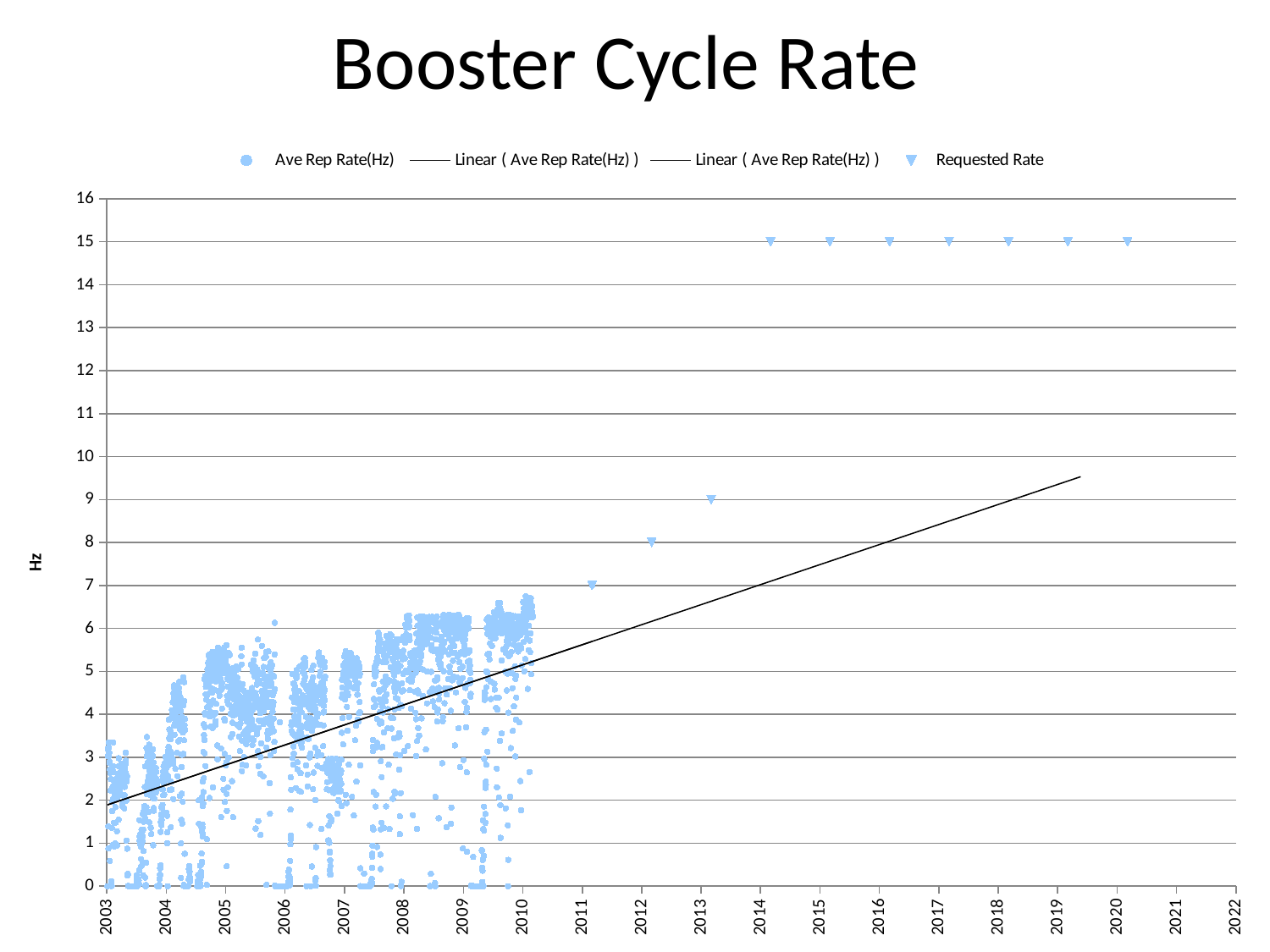
What kind of chart is shown on the slide? scatter chart What is the highest Requested Rate value plotted? 15 Which is larger, the Requested Rate at 2013 or at 2011? 2013 What is the title of the chart? Booster Cycle Rate What is the Requested Rate value plotted at 2014? 15 Is the value of the linear trend line at 2019 greater or less than 9? greater What is the label on the vertical axis? Hz How many Requested Rate points are plotted? 10 What is the Requested Rate value plotted at 2011? 7 How many series does the legend list? 4 Does the linear trend line rise or fall from 2003 to 2019? rise What is the difference between the Requested Rate at 2014 and at 2011? 8